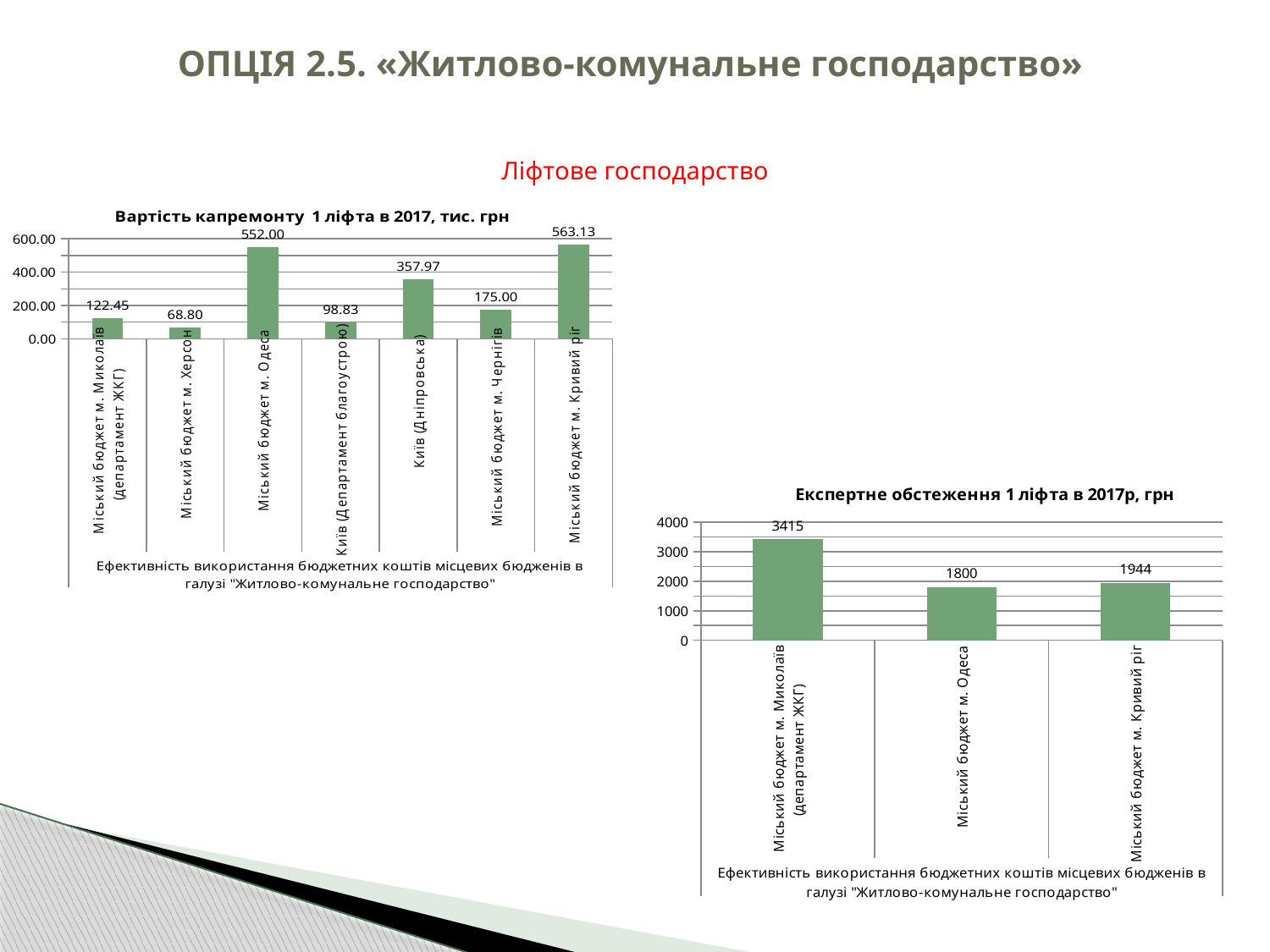
In the chart titled "Експертне обстеження 1 ліфта в 2017р, грн", how many categories are shown? 3 In the chart titled "Вартість капремонту 1 ліфта в 2017, тис. грн", which category has the highest value? Міський бюджет м. Кривий ріг In the chart titled "Вартість капремонту 1 ліфта в 2017, тис. грн", what is the difference between the values for Міський бюджет м. Чернігів and Міський бюджет м. Херсон? 106.20 In the chart titled "Вартість капремонту 1 ліфта в 2017, тис. грн", which category has the lowest value? Міський бюджет м. Херсон In the chart titled "Вартість капремонту 1 ліфта в 2017, тис. грн", which is larger: the value for Міський бюджет м. Миколаїв or Київ (Департамент благоустрою)? Міський бюджет м. Миколаїв In the chart titled "Експертне обстеження 1 ліфта в 2017р, грн", what is the value for Міський бюджет м. Миколаїв? 3415 In the chart titled "Вартість капремонту 1 ліфта в 2017, тис. грн", how many categories are shown? 7 In the chart titled "Експертне обстеження 1 ліфта в 2017р, грн", what is the difference between the values for Міський бюджет м. Кривий ріг and Міський бюджет м. Одеса? 144 In the chart titled "Експертне обстеження 1 ліфта в 2017р, грн", which category has the lowest value? Міський бюджет м. Одеса What type of chart is the chart titled "Експертне обстеження 1 ліфта в 2017р, грн"? Bar chart In the chart titled "Вартість капремонту 1 ліфта в 2017, тис. грн", what is the value for Київ (Дніпровська)? 357.97 In the chart titled "Вартість капремонту 1 ліфта в 2017, тис. грн", what is the value for Міський бюджет м. Одеса? 552.00